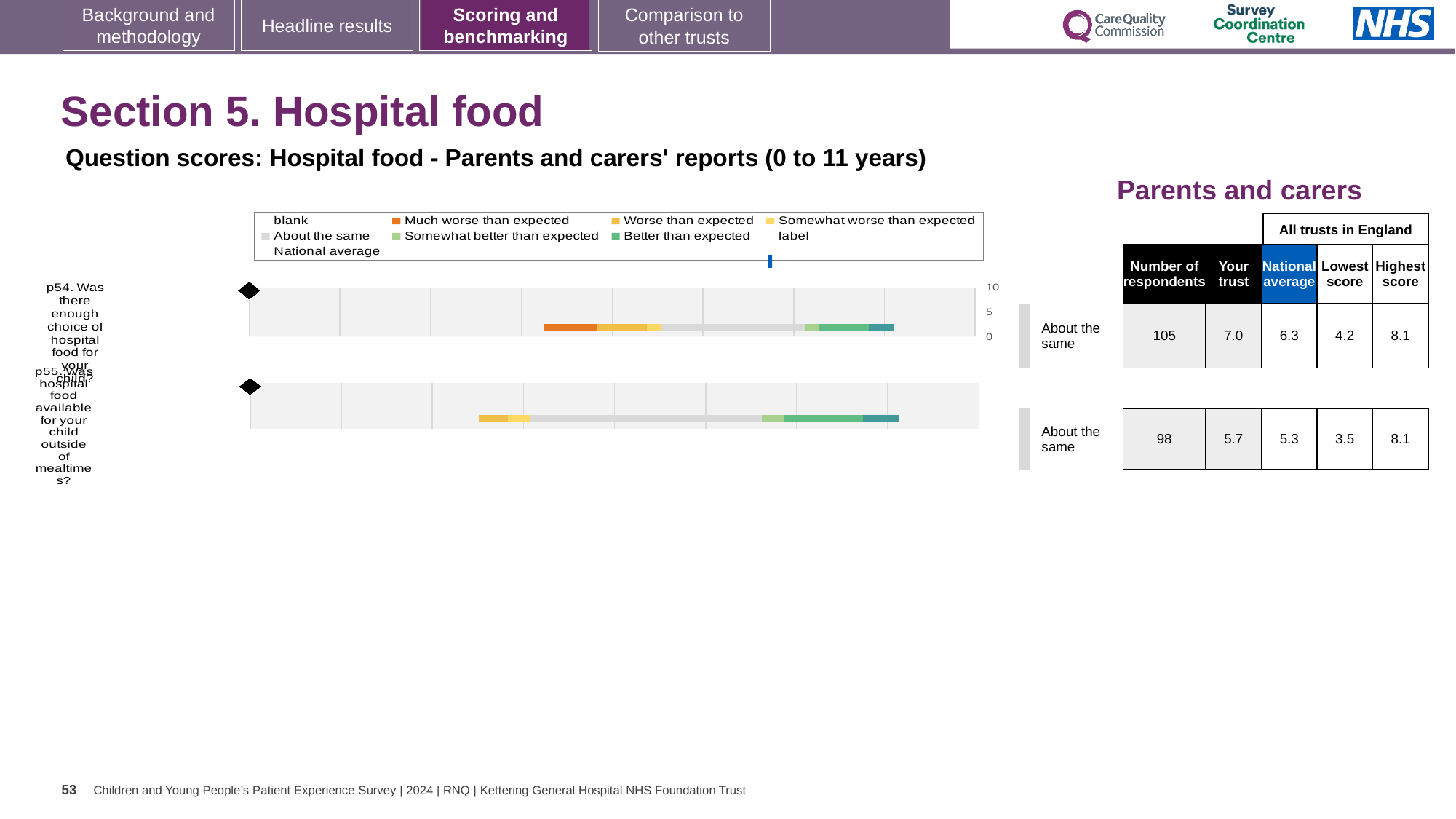
Which question has the higher 'Your trust' score, p54 or p55? p54 What is the difference between the 'Your trust' score and the national average for p54? 0.7 What is the highest score across all trusts in England for p55? 8.1 What kind of chart is used to show the question scores for hospital food? Bar chart What benchmark category is shown next to the chart for p54? About the same What is the difference between the highest score and the lowest score for p55? 4.6 In the table beside the chart, what is the 'Your trust' score for p54 (enough choice of hospital food)? 7.0 For p54, which is higher: the 'Your trust' score or the national average? Your trust In the table beside the chart, what is the national average score for p55 (hospital food available outside of mealtimes)? 5.3 How many questions (bars) are plotted in the hospital food chart? 2 How many respondents answered p54 according to the table beside the chart? 105 What colour represents 'Much worse than expected' in the chart legend? Orange